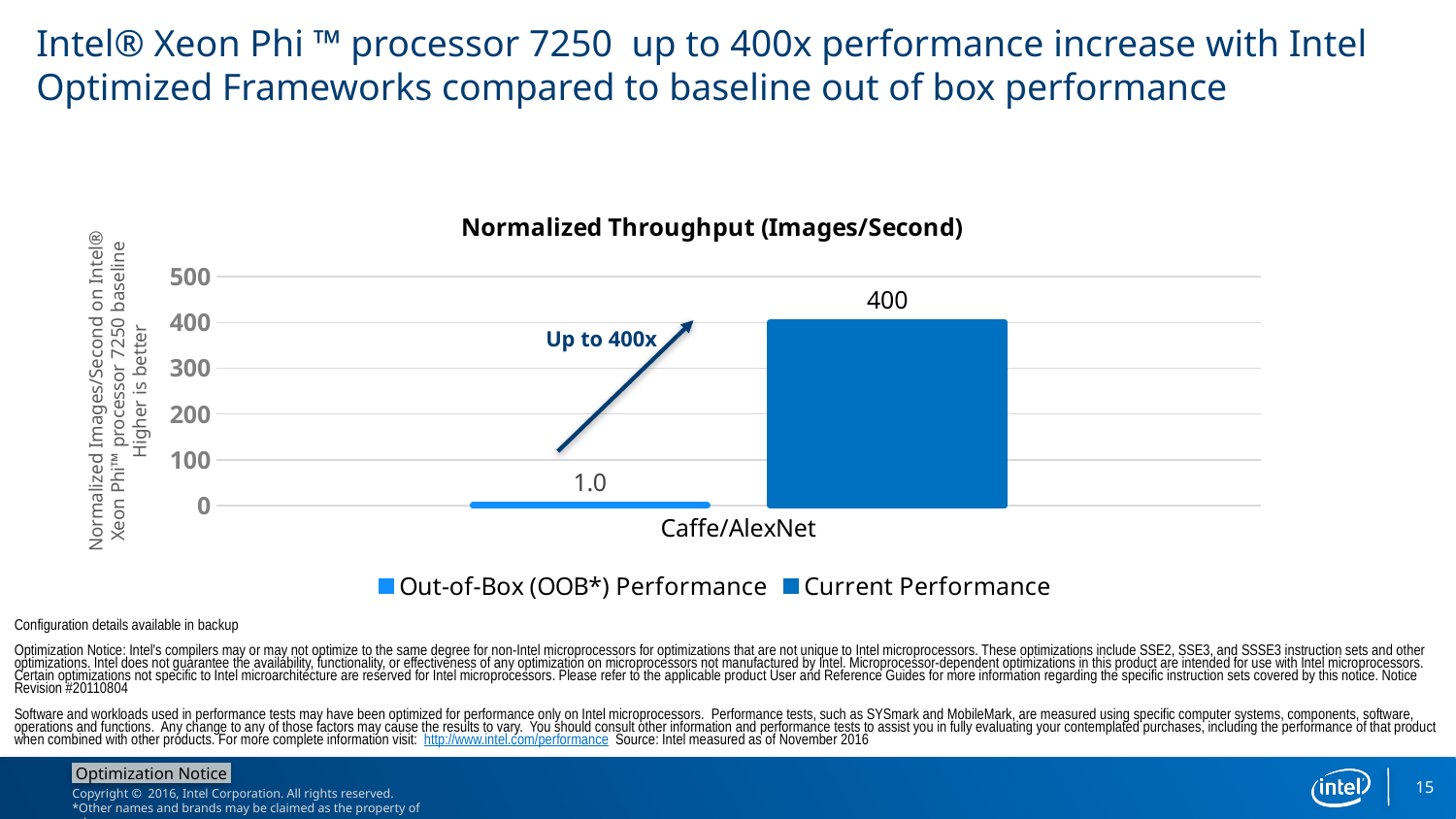
Is the Current Performance value for Caffe/AlexNet greater or less than 300? greater Which series has the higher value for Caffe/AlexNet, Out-of-Box (OOB*) Performance or Current Performance? Current Performance What is the highest value labelled on the chart's y axis? 500 What is the difference between the Current Performance value and the Out-of-Box (OOB*) Performance value for Caffe/AlexNet? 399.0 Is the Out-of-Box (OOB*) Performance value for Caffe/AlexNet greater or less than 100? less What kind of chart is shown on the slide? Bar chart What is the value of Out-of-Box (OOB*) Performance for Caffe/AlexNet? 1.0 How many series does the chart legend list? 2 How many categories are shown on the x axis of the chart? 1 What is the title of the chart? Normalized Throughput (Images/Second) Which series has the lowest value in the chart? Out-of-Box (OOB*) Performance What is the value of Current Performance for Caffe/AlexNet? 400